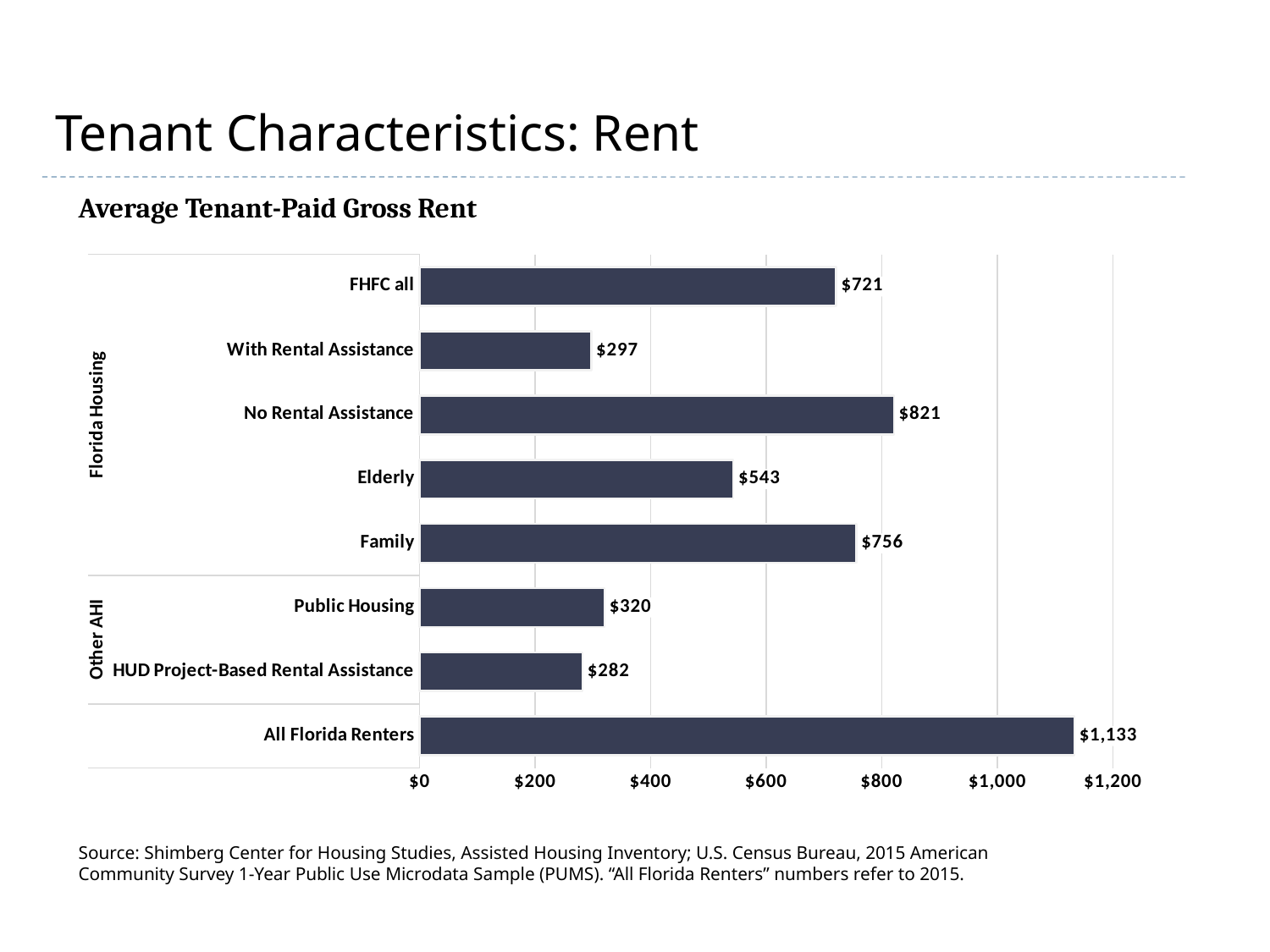
Which is larger, the rent for Family or the rent for Elderly? Family What is the average tenant-paid gross rent for Elderly? $543 What is the average tenant-paid gross rent for HUD Project-Based Rental Assistance? $282 What is the difference between the rent for All Florida Renters and FHFC all? $412 How many categories are shown in the chart? 8 Which category has the highest average tenant-paid gross rent? All Florida Renters What kind of chart is shown on the slide? bar chart Which category has the lowest average tenant-paid gross rent? HUD Project-Based Rental Assistance What is the title of the chart? Average Tenant-Paid Gross Rent What is the average tenant-paid gross rent for FHFC all? $721 What is the difference between the rent for No Rental Assistance and With Rental Assistance? $524 Is the value for Public Housing greater or less than $400? less